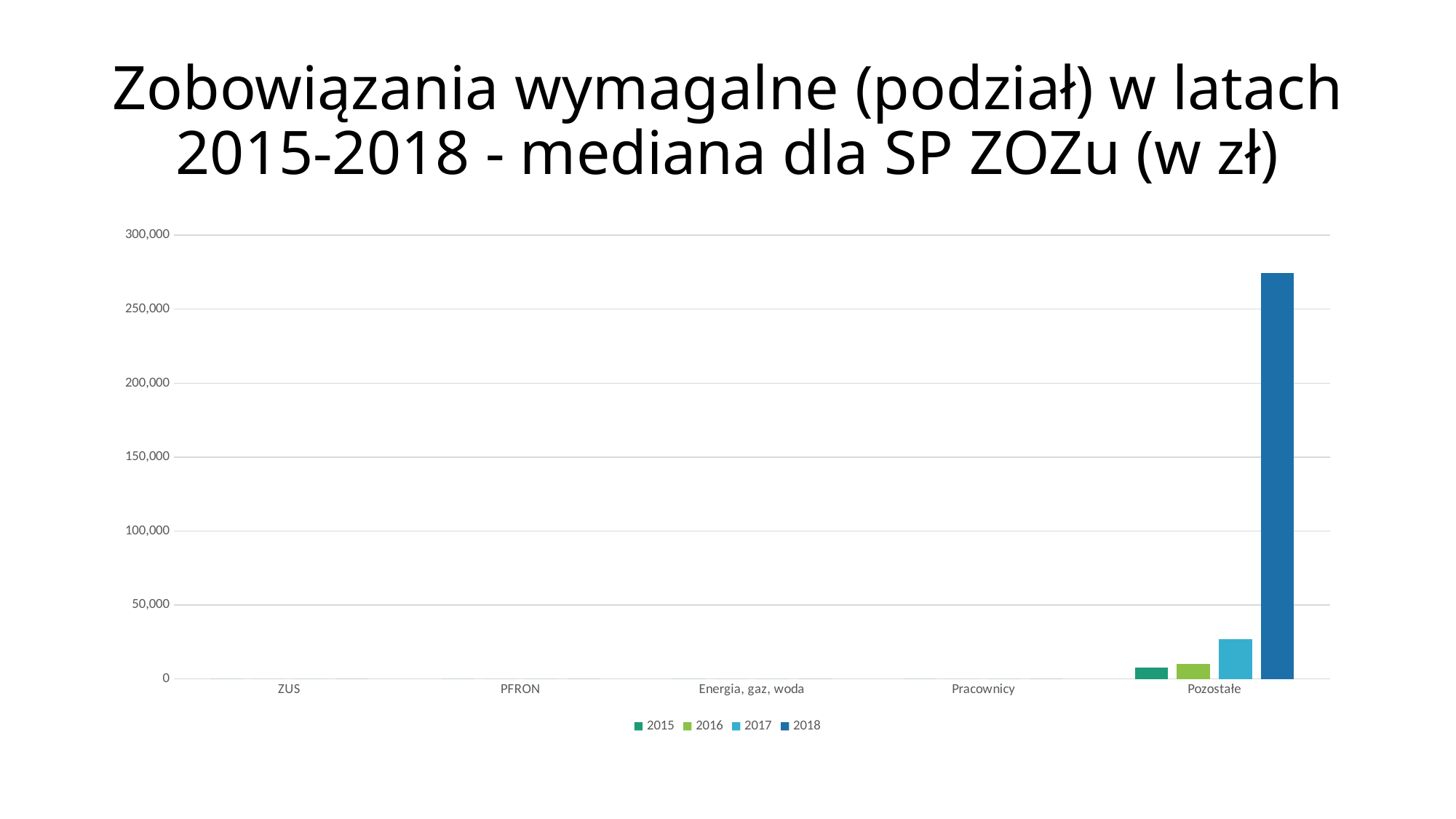
Is the 2017 value for Pozostałe greater or less than 50,000? less Which year is shown in the darkest blue colour in the legend? 2018 For the Pozostałe category, do the values rise or fall from 2015 to 2018? rise For Pozostałe, which is larger: the 2017 value or the 2018 value? 2018 For the Pozostałe category, which year has the highest value? 2018 How many categories are shown on the x axis? 5 Which category has the highest value for the 2018 series? Pozostałe What kind of chart is shown on the slide? bar chart Is the 2018 value for Pozostałe greater or less than 250,000? greater Is the 2018 value for Pozostałe greater or less than 300,000? less For Pozostałe, which is larger: the 2016 value or the 2017 value? 2017 How many series does the legend list? 4